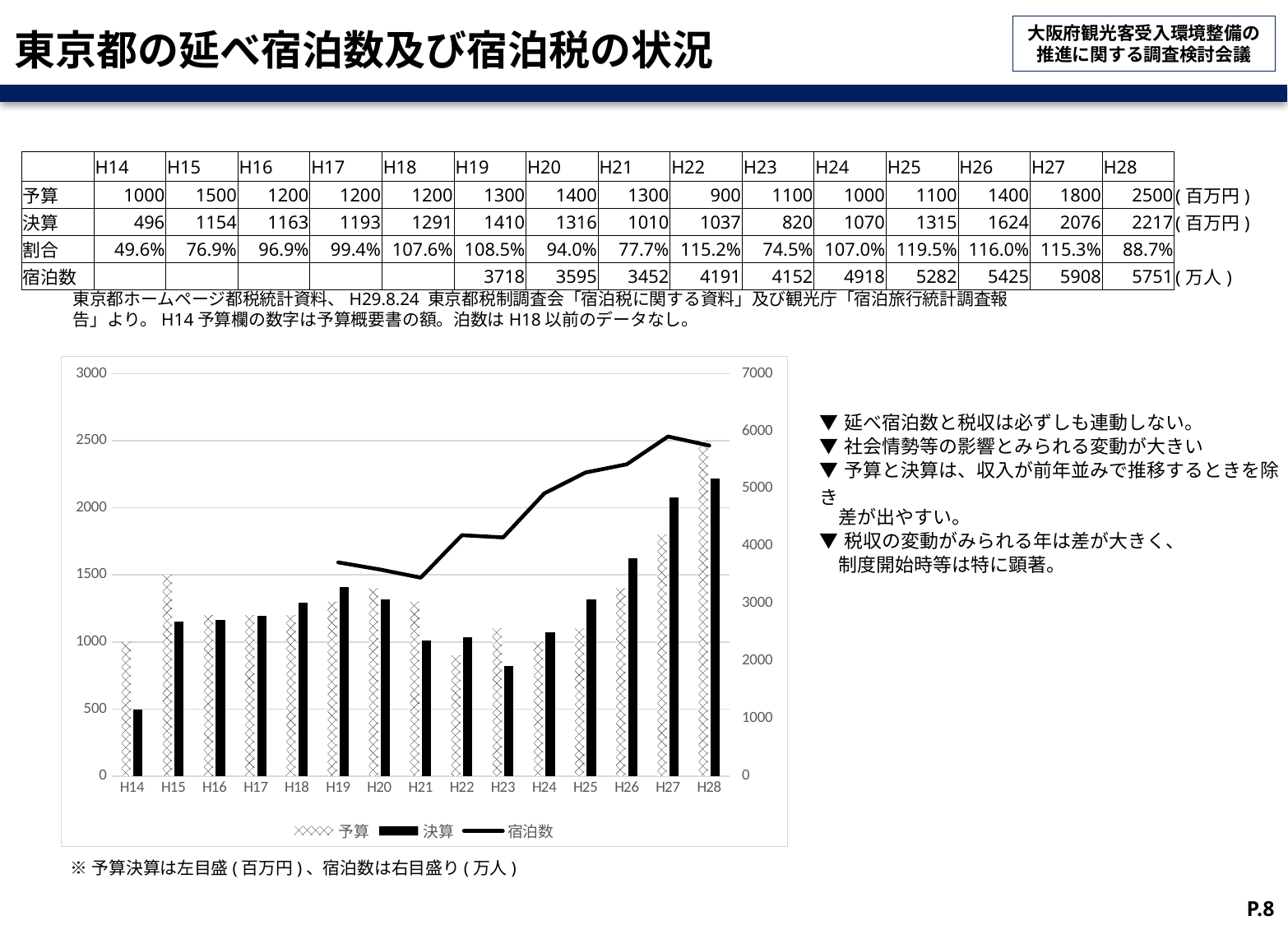
Is the 決算 value for H23 greater or less than 1000? less In which year does the 宿泊数 line reach its peak? H27 Which year has the lowest 予算 (budget) bar in the chart? H22 What is the difference between the 予算 and 決算 values for H28? 283 What kind of chart is shown on the slide? A combined bar and line chart How many series does the chart legend list? 3 Is the 宿泊数 value for H27 greater or less than 5000 on the right axis? greater Which year has the highest 決算 (settlement) bar in the chart? H28 How many years (categories) are plotted along the x axis of the chart? 15 What is the 決算 value for H28 as printed in the table? 2217 Which year has the lowest 決算 (settlement) bar in the chart? H14 Does the 宿泊数 line generally rise or fall from H21 to H27? rise